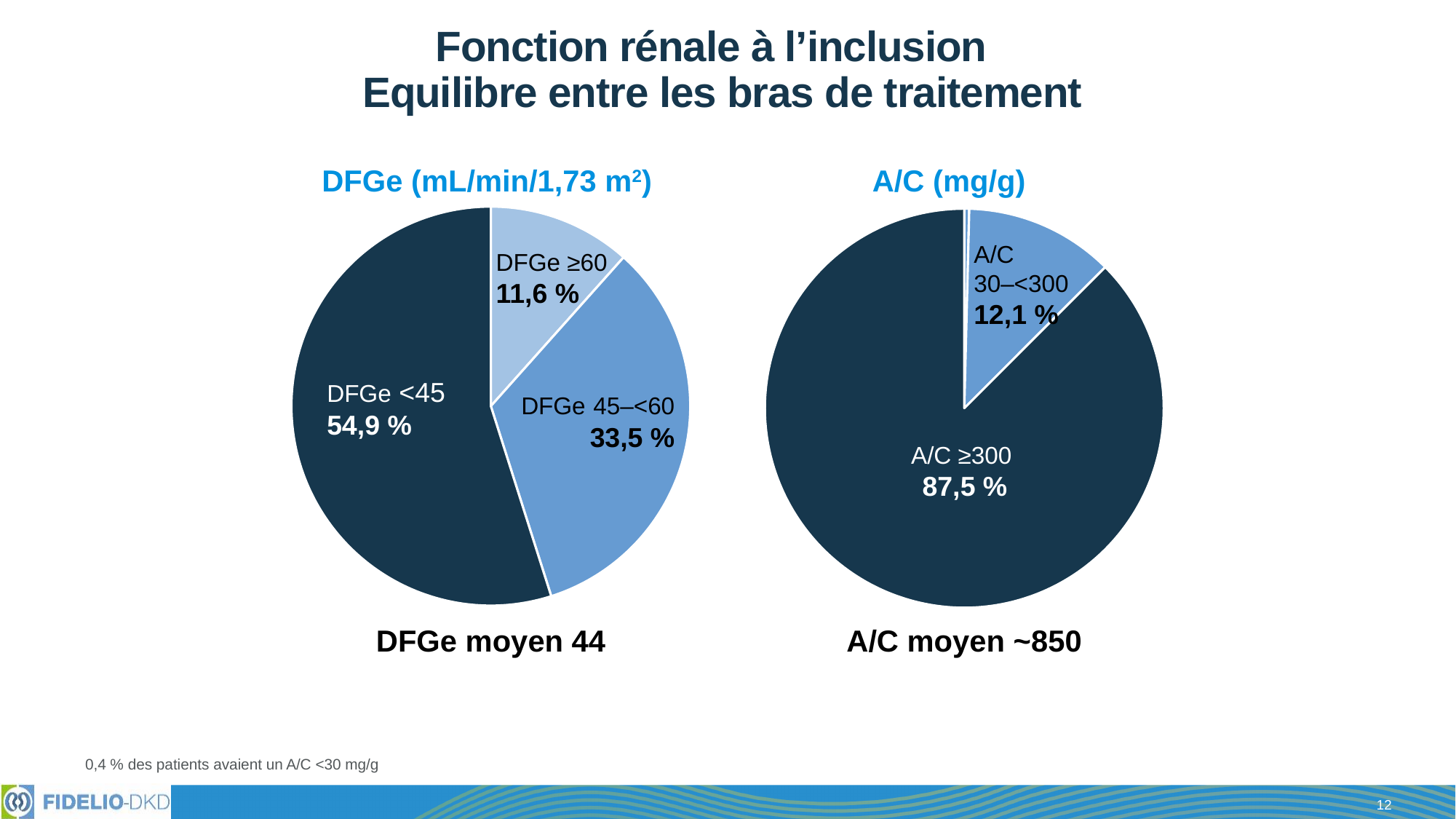
In the A/C (mg/g) chart, what percentage of patients had A/C ≥300? 87,5 % How many labeled categories are shown in the DFGe (mL/min/1,73 m²) chart? 3 In the DFGe (mL/min/1,73 m²) chart, what is the difference between the DFGe <45 share and the DFGe 45–<60 share? 21,4 % What type of chart is used for the DFGe (mL/min/1,73 m²) data? Pie chart In the DFGe (mL/min/1,73 m²) chart, what percentage of patients had DFGe <45? 54,9 % In the DFGe (mL/min/1,73 m²) chart, which category has the largest share? DFGe <45 In the DFGe (mL/min/1,73 m²) chart, what percentage of patients had DFGe ≥60? 11,6 % In the DFGe (mL/min/1,73 m²) chart, which category has the smallest share? DFGe ≥60 In the A/C (mg/g) chart, which is larger: the A/C ≥300 share or the A/C 30–<300 share? A/C ≥300 In the DFGe (mL/min/1,73 m²) chart, what percentage of patients had DFGe 45–<60? 33,5 % In the A/C (mg/g) chart, what percentage of patients had A/C 30–<300? 12,1 % In the A/C (mg/g) chart, what is the difference between the A/C ≥300 share and the A/C 30–<300 share? 75,4 %